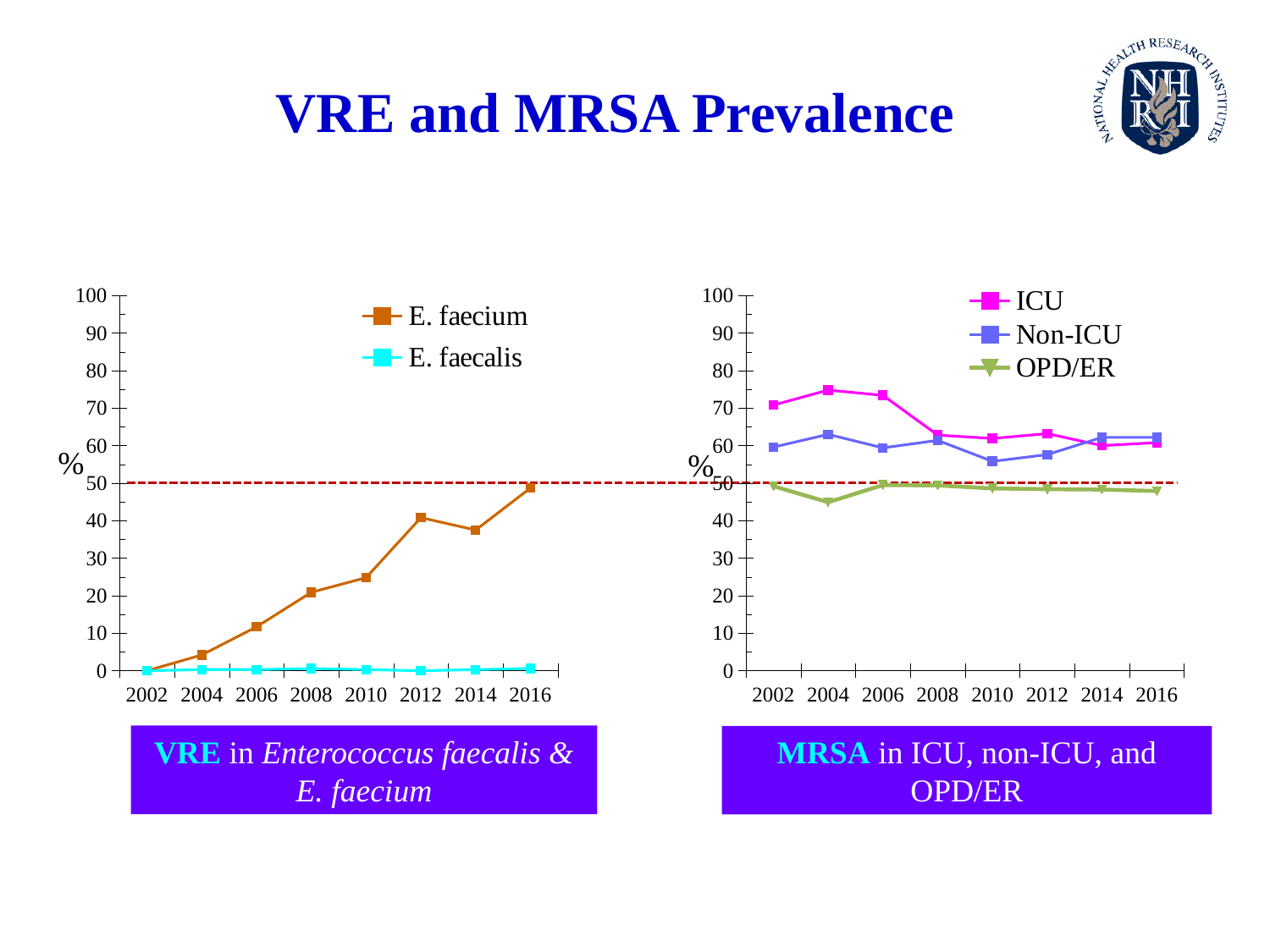
In the left chart (VRE), is the value for E. faecium in 2012 greater or less than 30? greater In the right chart (MRSA), does the ICU series rise or fall from 2004 to 2016? fall How many years are plotted along the x axis of the left chart (VRE)? 8 In the right chart (MRSA), which series has the highest value in 2002? ICU In the left chart (VRE), which series has the higher value in 2014, E. faecium or E. faecalis? E. faecium What kind of chart is the left chart (VRE in Enterococcus faecalis & E. faecium)? line chart In the left chart (VRE), is the value for E. faecalis in 2016 greater or less than 10? less In the right chart (MRSA), which series has the lowest value in 2004? OPD/ER How many series does the legend of the right chart (MRSA in ICU, non-ICU, and OPD/ER) list? 3 In the right chart (MRSA), is the value for ICU in 2004 greater or less than 70? greater How many series does the legend of the left chart (VRE) list? 2 In the left chart (VRE), does the E. faecium series rise or fall from 2002 to 2016? rise